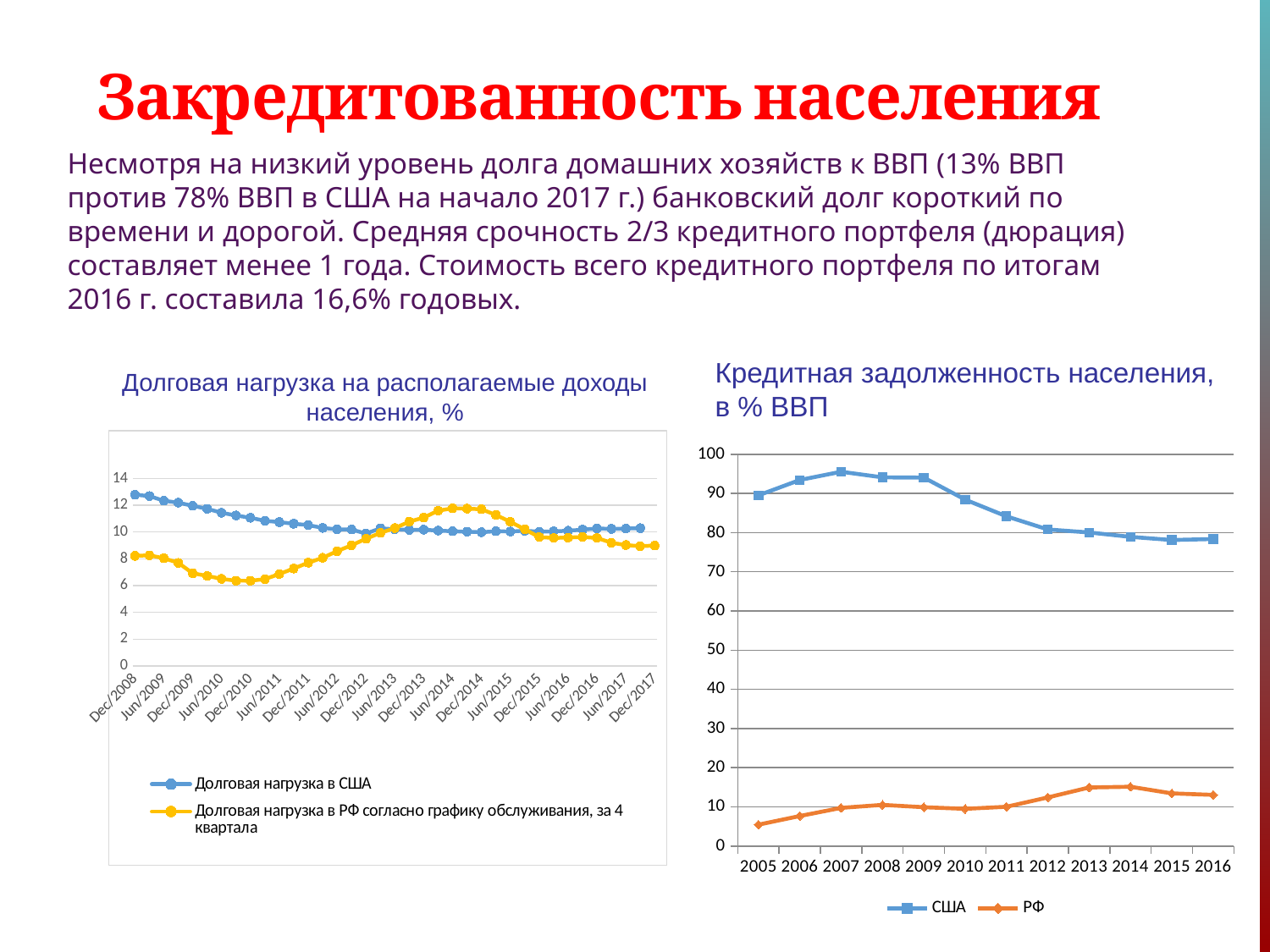
In the chart "Долговая нагрузка на располагаемые доходы населения, %", is the value for "Долговая нагрузка в США" at Dec/2008 greater or less than 12? greater In the chart "Кредитная задолженность населения, в % ВВП", is the value for РФ in 2013 greater or less than 10? greater In the chart "Долговая нагрузка на располагаемые доходы населения, %", is the value for the РФ series at Dec/2010 greater or less than 8? less In the chart "Кредитная задолженность населения, в % ВВП", does the США series rise or fall from 2007 to 2015? fall In the chart "Кредитная задолженность населения, в % ВВП", which series has the higher value in 2016, США or РФ? США How many series does the legend of the chart "Долговая нагрузка на располагаемые доходы населения, %" list? 2 How many series does the legend of the chart "Кредитная задолженность населения, в % ВВП" list? 2 What kind of chart is the chart titled "Кредитная задолженность населения, в % ВВП"? line chart How many years are shown on the x axis of the chart "Кредитная задолженность населения, в % ВВП"? 12 In the chart "Кредитная задолженность населения, в % ВВП", in which year is the США series at its highest? 2007